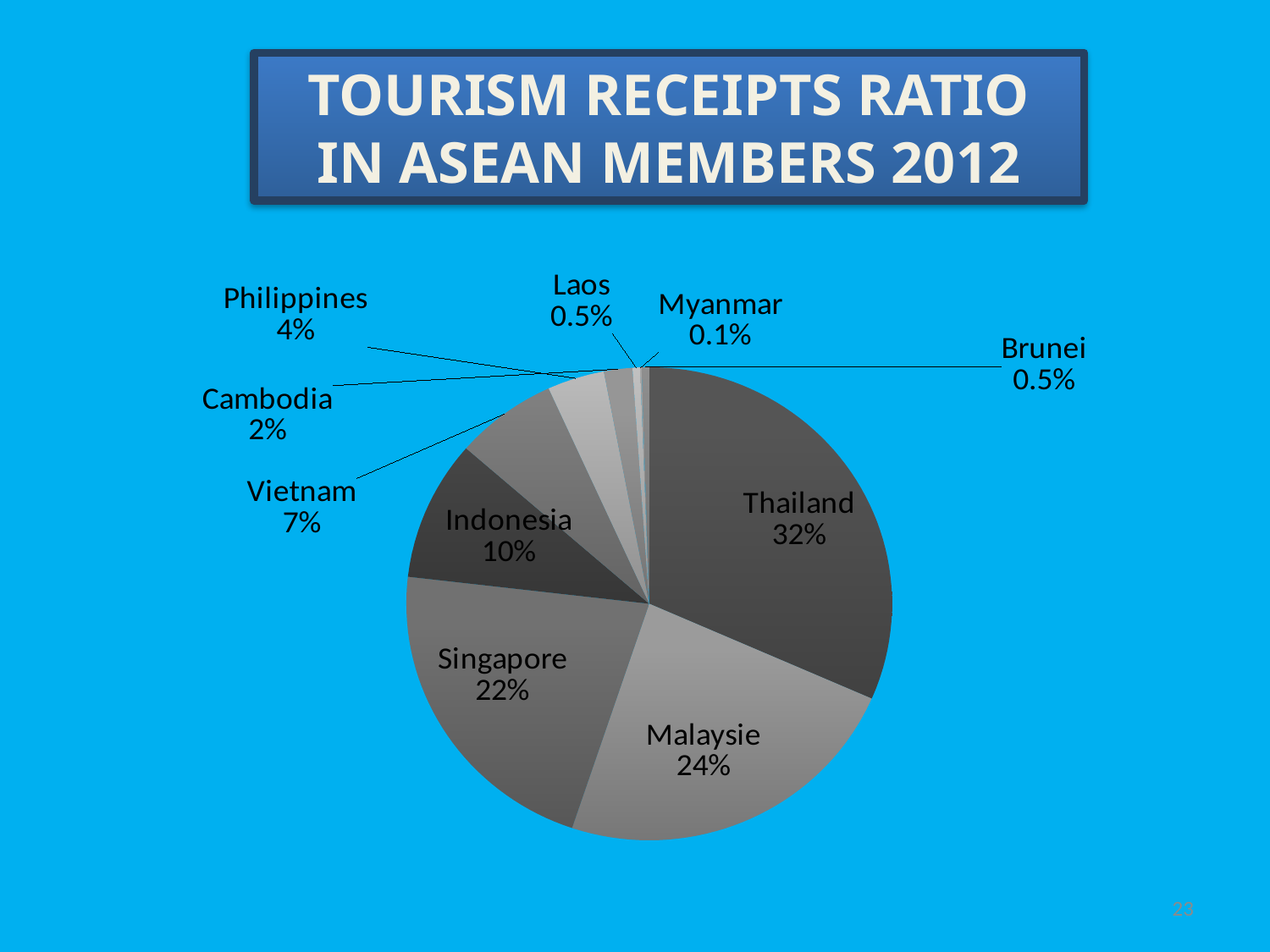
What kind of chart is shown on the slide? pie chart What is the tourism receipts share for Thailand? 32% Which country has the largest share of tourism receipts? Thailand What is the title of the chart on the slide? TOURISM RECEIPTS RATIO IN ASEAN MEMBERS 2012 Which country has the smallest share of tourism receipts? Myanmar What is the tourism receipts share for Singapore? 22% How many countries are shown in the pie chart? 10 Which has a larger share, Indonesia or Vietnam? Indonesia What is the difference in percentage points between Thailand's and Malaysie's shares? 8 What is the tourism receipts share for Vietnam? 7% What is the tourism receipts share for Myanmar? 0.1% What is the difference in percentage points between Singapore's and Indonesia's shares? 12